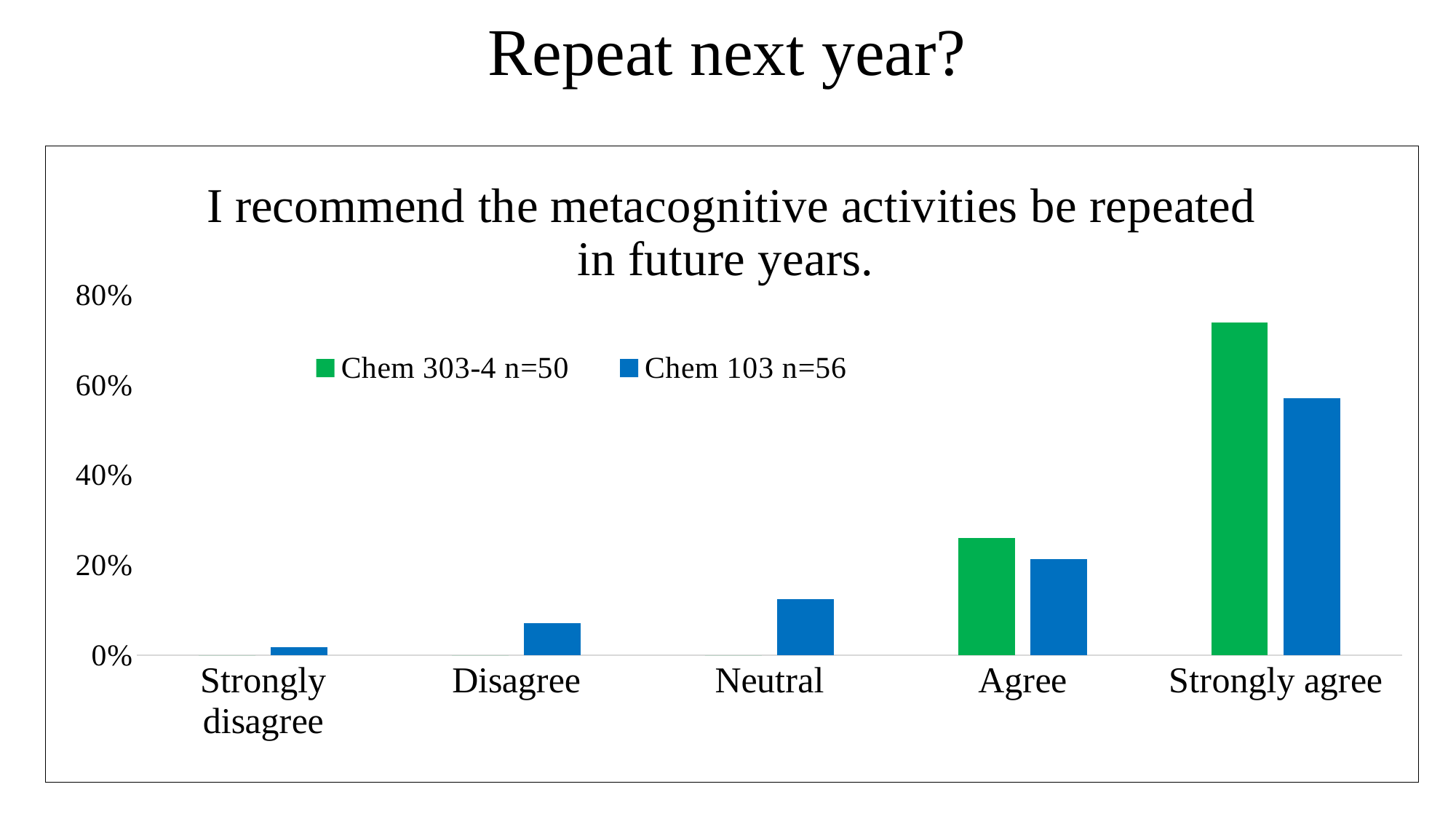
For Strongly agree, which series has the larger value: Chem 303-4 n=50 or Chem 103 n=56? Chem 303-4 n=50 Do the values for Chem 103 n=56 rise or fall from Strongly disagree to Strongly agree? rise What is the title of the chart? I recommend the metacognitive activities be repeated in future years. What kind of chart is shown on the slide? Bar chart How many response categories are shown on the x axis? 5 Which category has the highest value for Chem 303-4 n=50? Strongly agree How many series does the legend list? 2 Which category has the highest value for Chem 103 n=56? Strongly agree Is the value for Chem 303-4 n=50 at Strongly agree greater or less than 60%? greater Is the value for Chem 103 n=56 at Neutral greater or less than 20%? less Which category has the lowest value for Chem 103 n=56? Strongly disagree